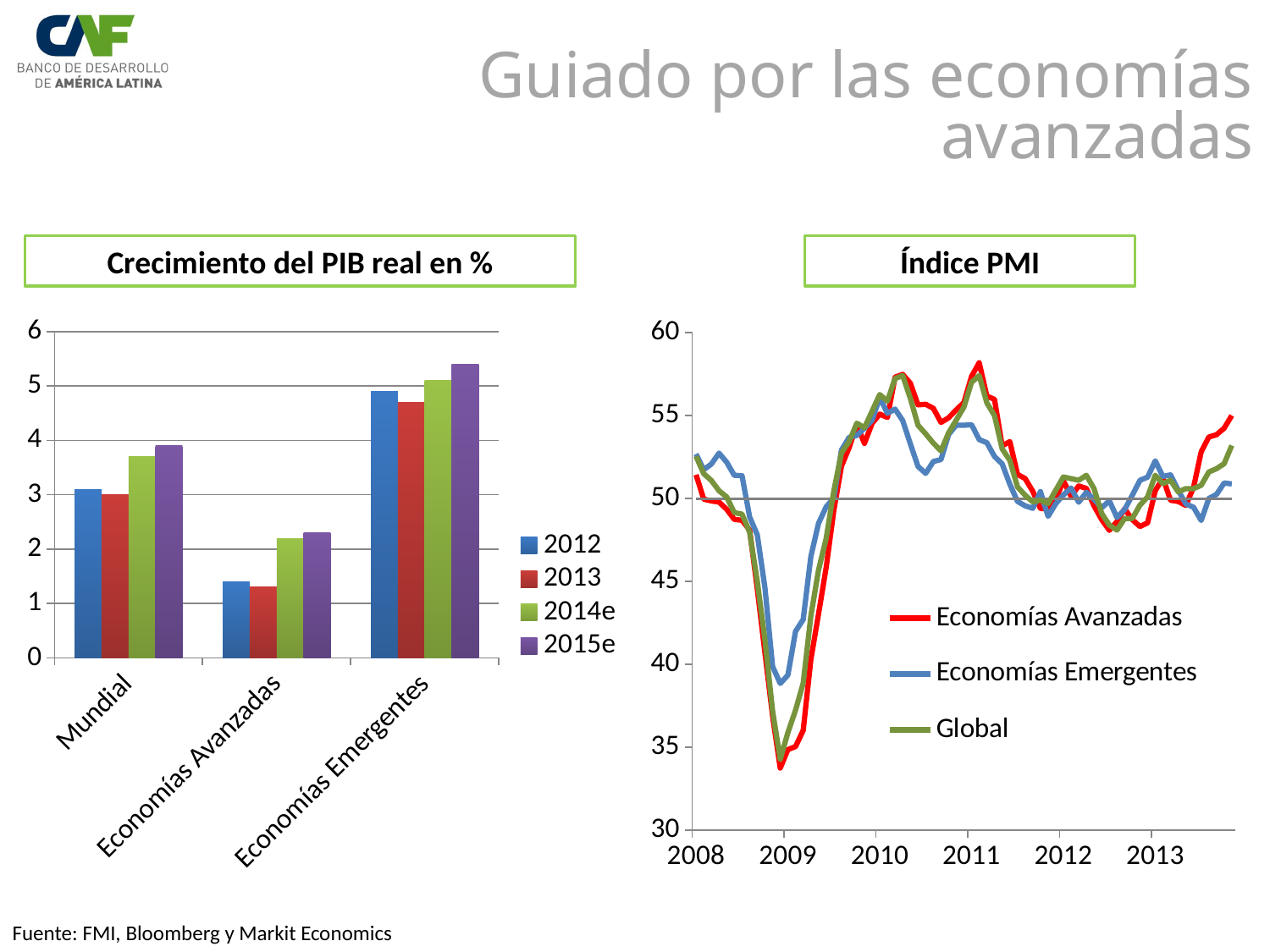
In the 'Índice PMI' chart, is the lowest value of the Economías Avanzadas line in 2009 greater or less than 35? less How many categories are shown on the x axis of the 'Crecimiento del PIB real en %' chart? 3 What kind of chart is the 'Índice PMI' chart? line chart How many series does the legend of the 'Índice PMI' chart list? 3 In the 'Crecimiento del PIB real en %' chart, is the 2015e value for Economías Emergentes greater or less than 5? greater In the 'Crecimiento del PIB real en %' chart, which category has the highest 2015e value? Economías Emergentes How many series does the legend of the 'Crecimiento del PIB real en %' chart list? 4 In the 'Índice PMI' chart, which series is shown in red? Economías Avanzadas In the 'Crecimiento del PIB real en %' chart, is the 2013 value for Economías Avanzadas greater or less than 2? less What kind of chart is the 'Crecimiento del PIB real en %' chart? bar chart In the 'Crecimiento del PIB real en %' chart, which is larger for Mundial: the 2014e value or the 2012 value? 2014e In the 'Crecimiento del PIB real en %' chart, which category has the lowest 2012 value? Economías Avanzadas